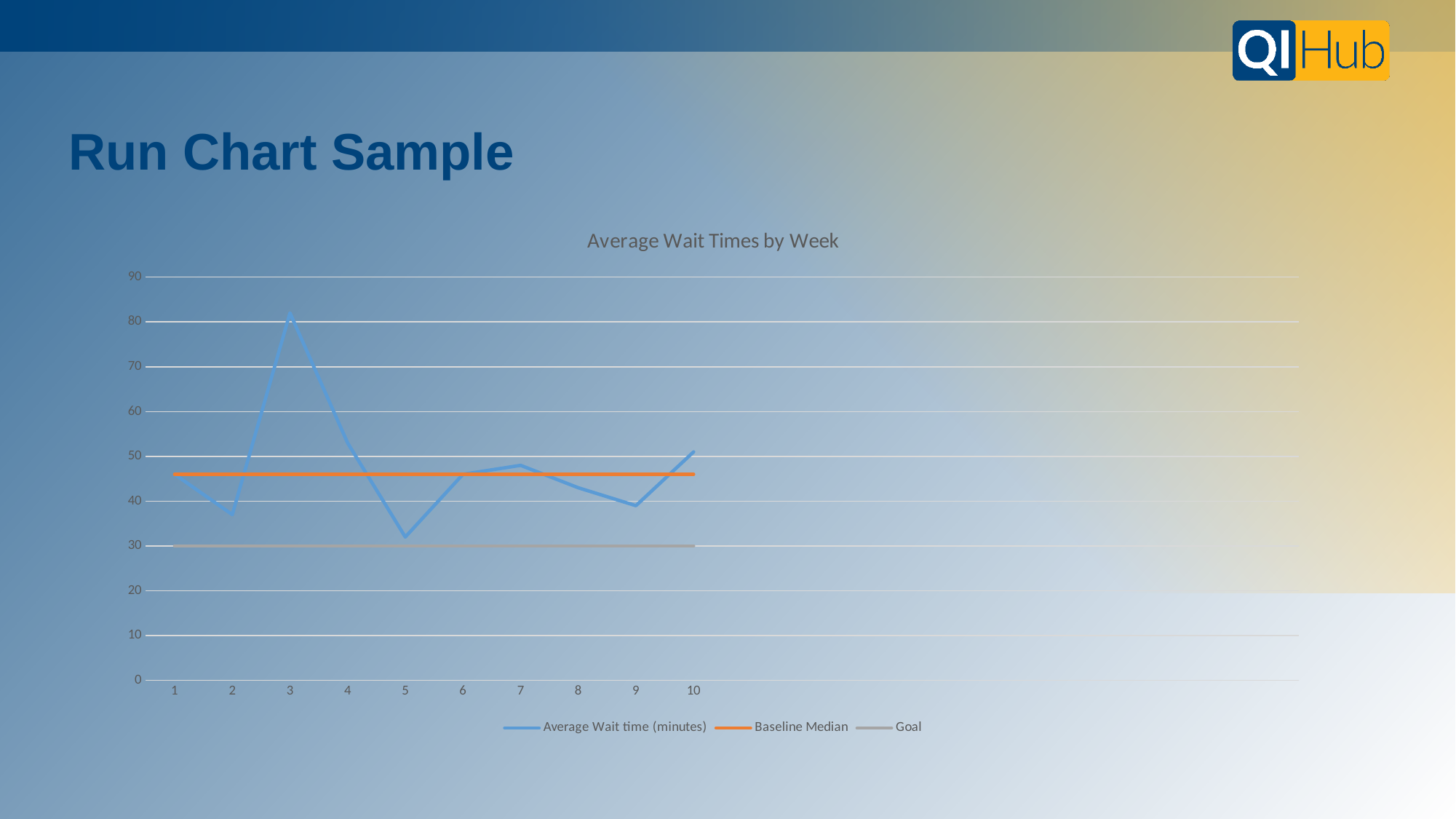
How many weeks are plotted along the x axis? 10 Which series is drawn in orange in the legend? Baseline Median What kind of chart is shown on the slide? line chart Does the average wait time rise or fall from week 3 to week 5? fall Is the average wait time in week 8 greater or less than 50? less In which week is the average wait time lowest? 5 In which week is the average wait time highest? 3 Which week has a larger average wait time, week 2 or week 4? week 4 How many series does the chart legend list? 3 What is the title of the chart? Average Wait Times by Week Is the average wait time in week 2 greater or less than 40? less Is the average wait time in week 3 greater or less than 70? greater